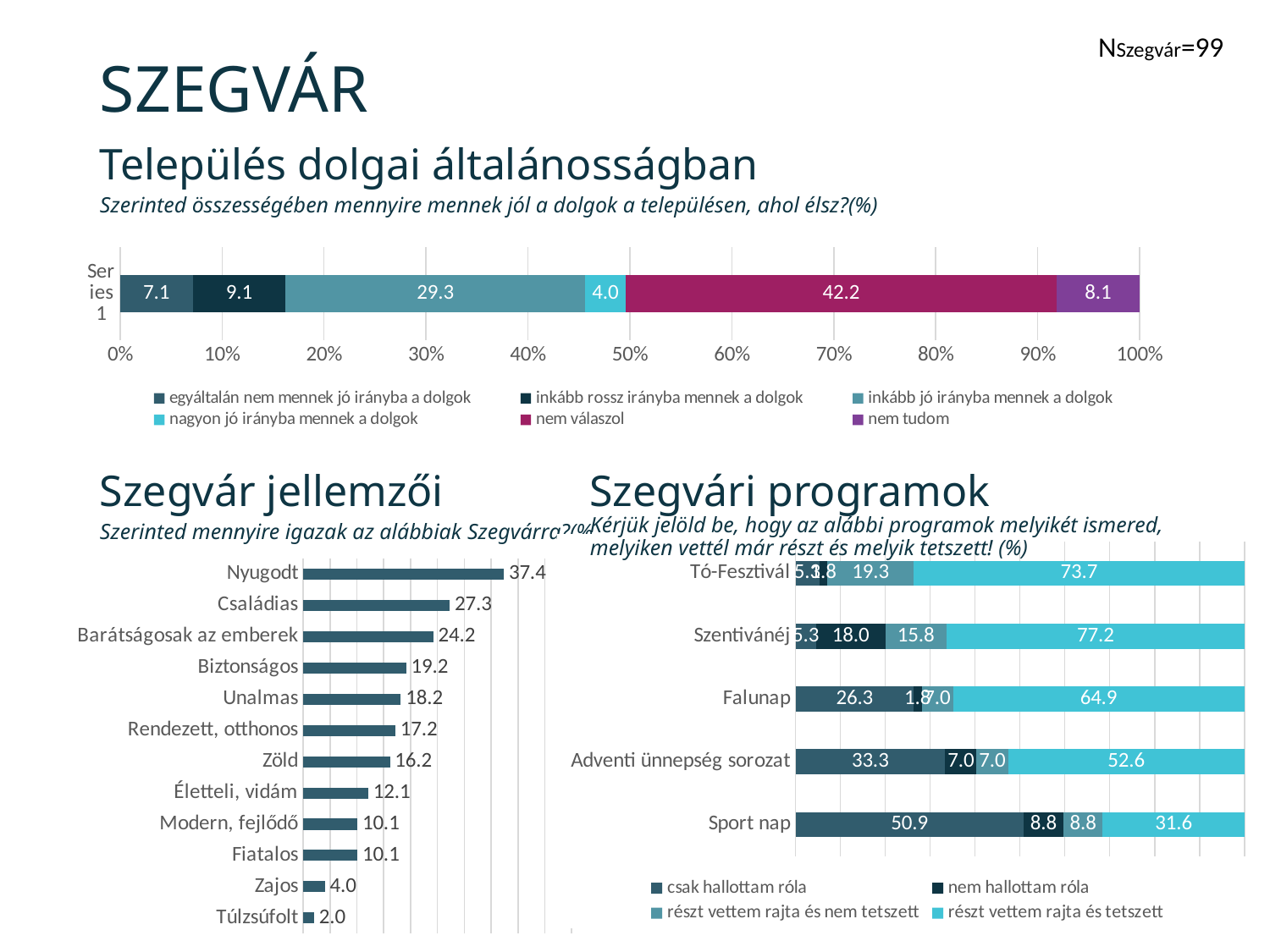
In the 'Szegvár jellemzői' chart, what is the value for 'Biztonságos'? 19.2 In the 'Település dolgai általánosságban' chart, what is the value for 'inkább jó irányba mennek a dolgok'? 29.3 In the 'Szegvár jellemzői' chart, which category has the lowest value? Túlzsúfolt In the 'Szegvári programok' chart, what is the value of 'részt vettem rajta és tetszett' for 'Szentivánéj'? 77.2 In the 'Település dolgai általánosságban' chart, what is the value for 'nem válaszol'? 42.2 What kind of chart is the 'Szegvár jellemzői' chart? Bar chart In the 'Szegvár jellemzői' chart, what is the difference between 'Nyugodt' and 'Családias'? 10.1 How many series does the legend of the 'Település dolgai általánosságban' chart list? 6 In the 'Szegvári programok' chart, what is the value of 'csak hallottam róla' for 'Sport nap'? 50.9 In the 'Szegvári programok' chart, which is larger: 'részt vettem rajta és tetszett' for 'Adventi ünnepség sorozat' or for 'Sport nap'? Adventi ünnepség sorozat In the 'Szegvár jellemzői' chart, which category has the highest value? Nyugodt How many categories are shown in the 'Szegvár jellemzői' chart? 12